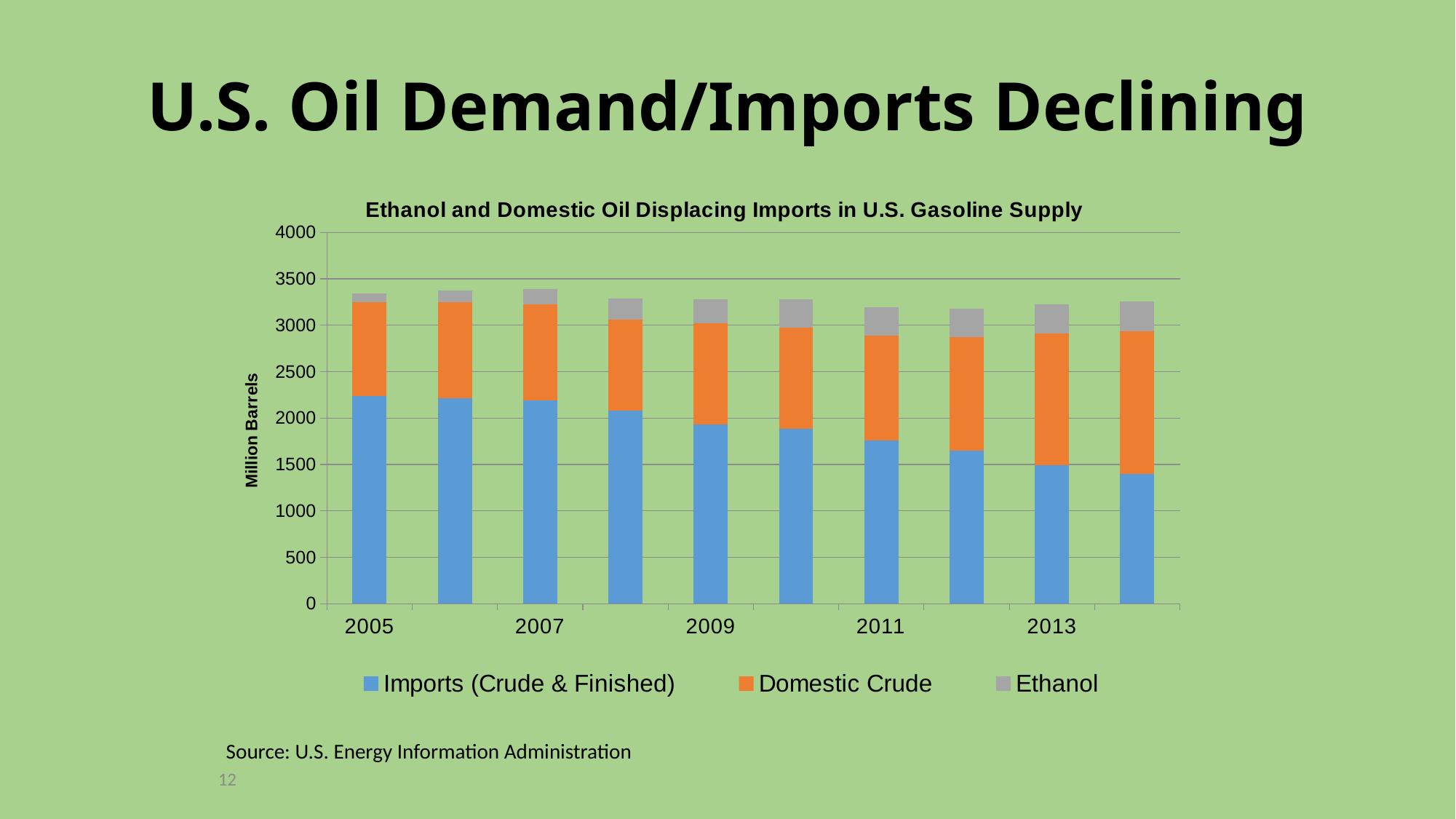
How many bars (years) are plotted in the chart? 10 How many series does the chart legend list? 3 What kind of chart is shown on the slide? stacked bar chart Does the Imports (Crude & Finished) series rise or fall from 2005 to the last year shown? fall Is the total height of the stacked bar for 2005 greater or less than 3500? less Is the value for Imports (Crude & Finished) in 2009 greater or less than 2000? less Is the value for Imports (Crude & Finished) in 2011 greater or less than 1500? greater What is the label on the vertical axis of the chart? Million Barrels What is the title of the chart? Ethanol and Domestic Oil Displacing Imports in U.S. Gasoline Supply Which is larger, the Imports (Crude & Finished) value for 2005 or for 2013? 2005 Which year has the highest value for Imports (Crude & Finished)? 2005